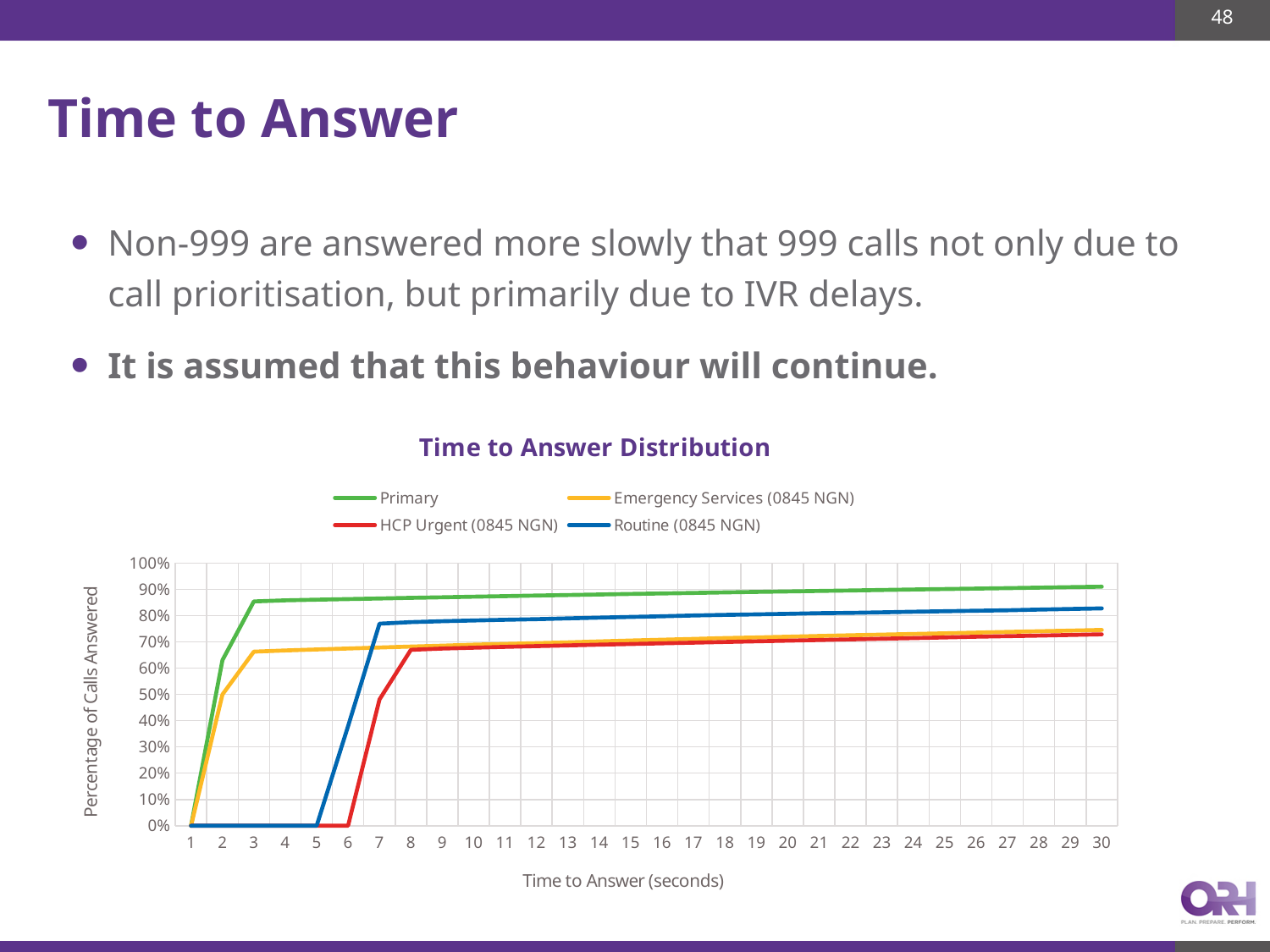
What is the label of the y axis? Percentage of Calls Answered Is the value for Primary at 10 seconds greater or less than 80%? greater What is the value for HCP Urgent (0845 NGN) at 5 seconds? 0% How many time-to-answer values (seconds) are shown along the x axis? 30 Which series has the lowest value at 6 seconds? HCP Urgent (0845 NGN) What is the value for Routine (0845 NGN) at 3 seconds? 0% At 15 seconds, which is larger: Primary or Routine (0845 NGN)? Primary Is the value for HCP Urgent (0845 NGN) at 20 seconds greater or less than 80%? less Which series has the highest value at 30 seconds? Primary How many series does the legend of the Time to Answer Distribution chart list? 4 Do the values for Primary rise or fall as time to answer increases from 1 to 30 seconds? Rise What type of chart is shown on the slide? Line chart